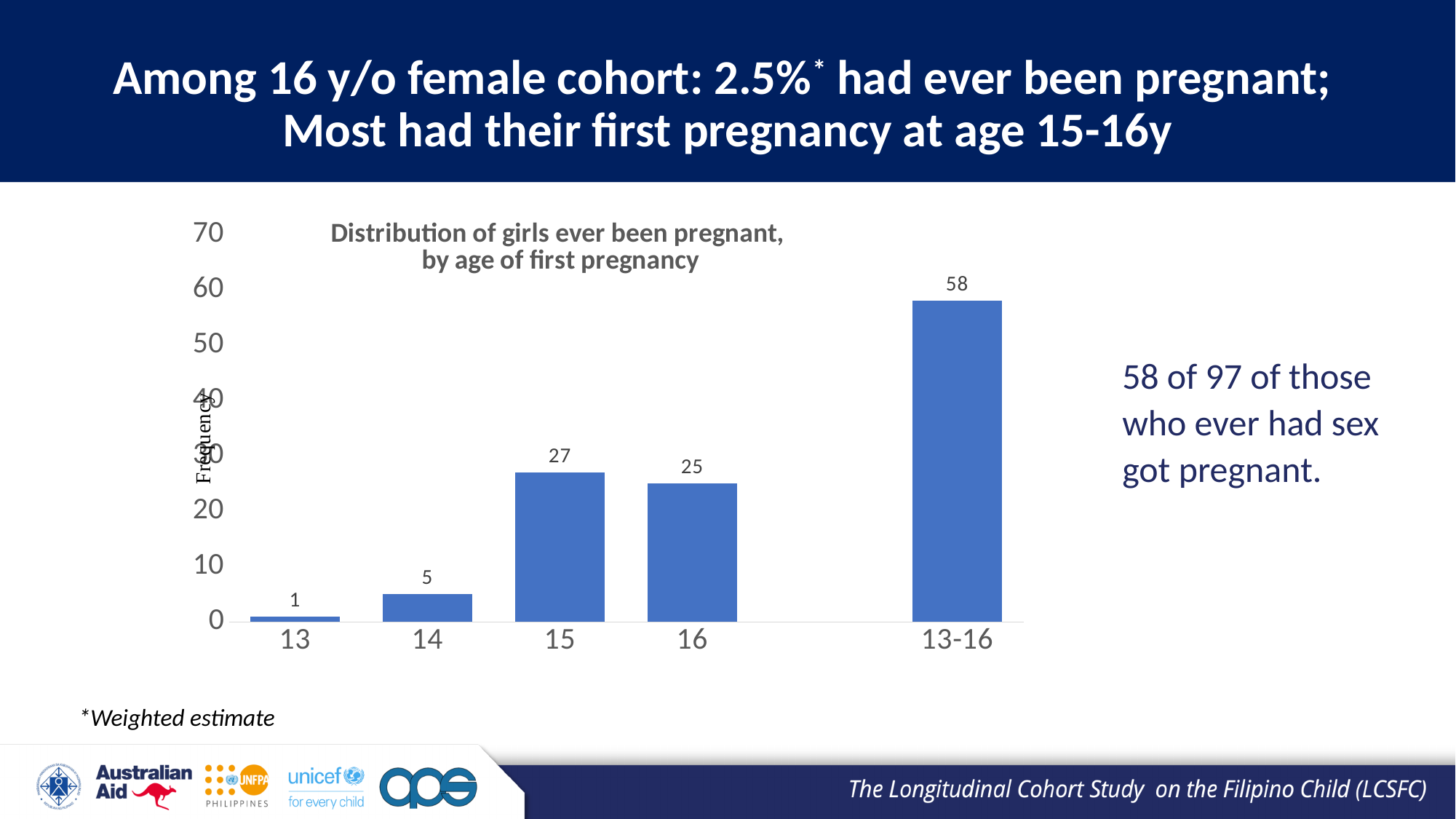
What is the value shown for the 13-16 bar? 58 What is the frequency for age 15 in the chart? 27 Is the value for the 13-16 bar greater or less than 50? greater Which category has the highest bar in the chart? 13-16 What is the frequency for age 13 in the chart? 1 How many bars are shown in the chart? 5 What is the difference between the frequency for age 14 and age 13? 4 What is the difference between the frequency for age 15 and age 16? 2 Which age category has the lowest frequency? 13 What kind of chart is shown on the slide? Bar chart What is the title of the chart? Distribution of girls ever been pregnant, by age of first pregnancy Which has a higher frequency, age 14 or age 16? 16